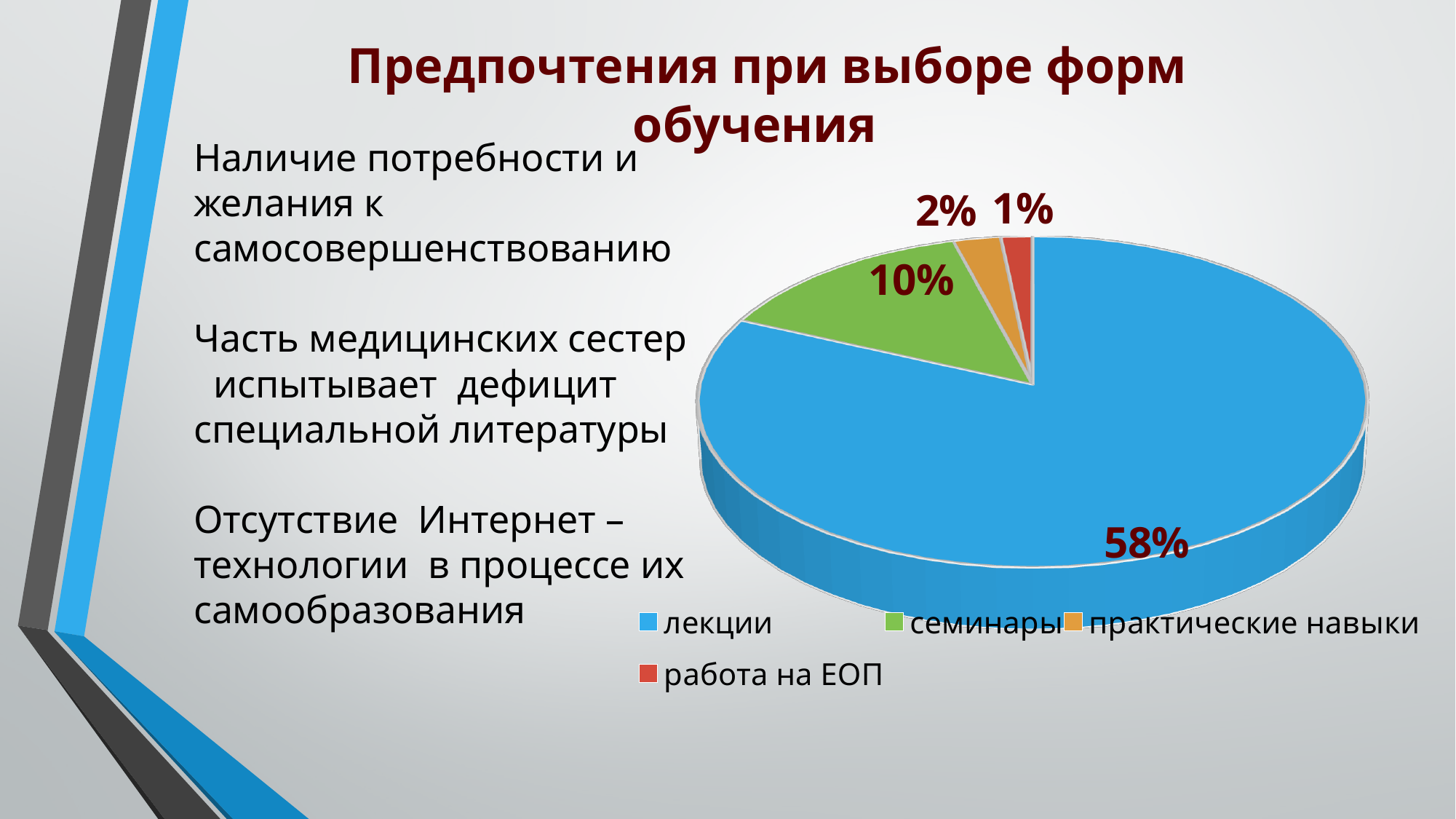
What percentage is shown for работа на ЕОП? 1% How many categories does the legend list? 4 What percentage is shown for практические навыки? 2% What is the title of the chart slide? Предпочтения при выборе форм обучения Which is larger, the slice for семинары or the slice for практические навыки? семинары What kind of chart is shown on the slide? pie chart Which category has the smallest slice of the pie? работа на ЕОП What colour is the slice for семинары? green What percentage is shown for семинары? 10% What percentage is shown for лекции? 58% What is the difference in percentage points between лекции and семинары? 48 Which category has the largest slice of the pie? лекции